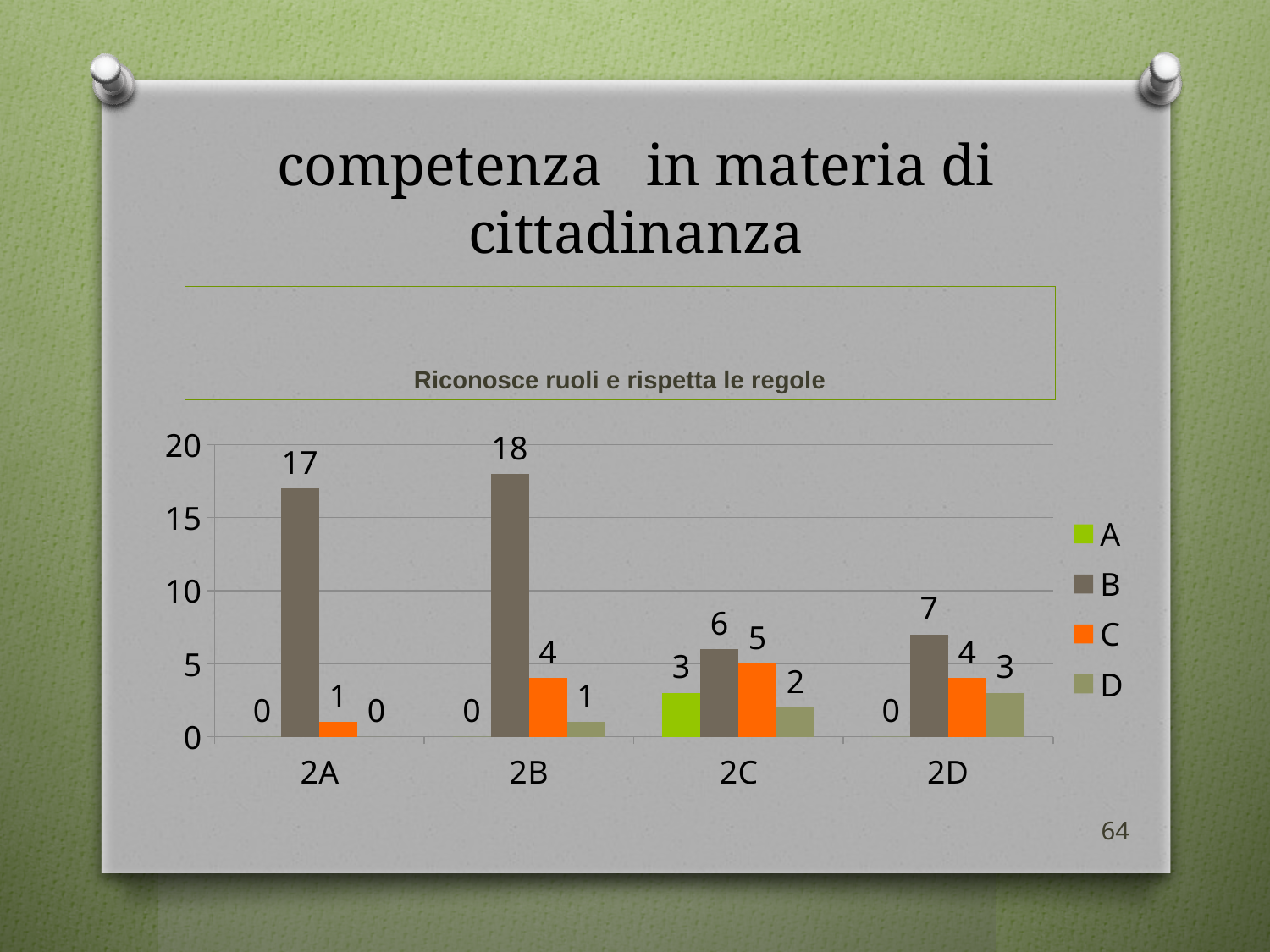
Which class has the highest value for series B? 2B What is the title of the chart? Riconosce ruoli e rispetta le regole Which class has the lowest value for series B? 2C What is the difference between the series B values for 2B and 2A? 1 What is the value of series C for class 2C? 5 How many series does the legend list? 4 What is the value of series A for class 2C? 3 What type of chart is shown? bar chart How many classes are shown on the x axis? 4 What is the value of series D for class 2D? 3 Which is larger: series C for 2B or series C for 2C? series C for 2C What is the value of series B for class 2B? 18